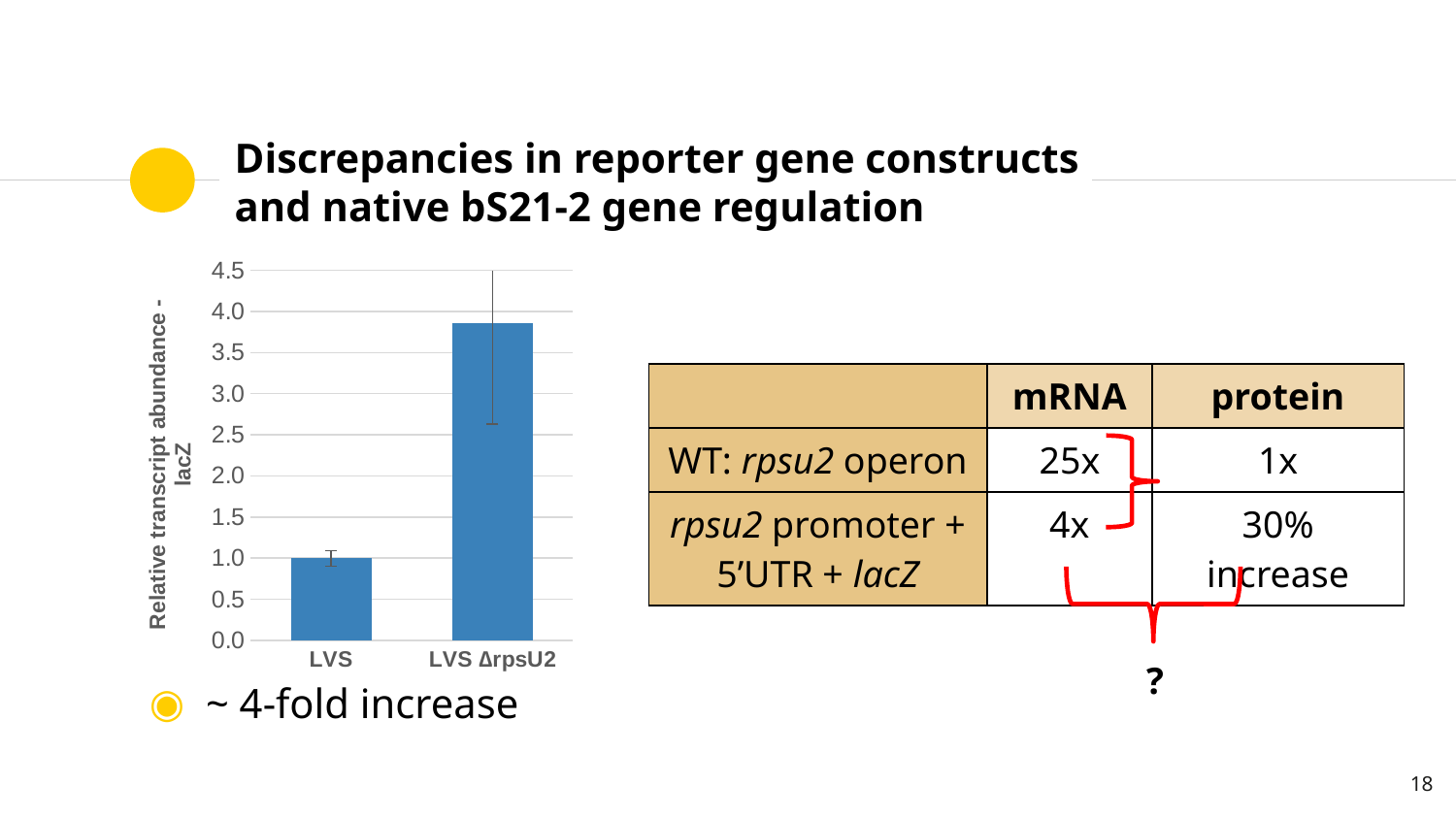
What is the y-axis title of the bar chart? Relative transcript abundance - lacZ Is the value for LVS ΔrpsU2 greater or less than 3.0? greater Which bar is taller, LVS or LVS ΔrpsU2? LVS ΔrpsU2 What is the highest tick value shown on the y axis of the bar chart? 4.5 Which category has the lowest relative transcript abundance in the bar chart? LVS What is the relative transcript abundance value for LVS in the bar chart? 1.0 Is the value for LVS greater or less than 1.5? less Is the value for LVS ΔrpsU2 greater or less than 4.5? less What kind of chart is shown on the slide? bar chart How many categories are plotted on the x axis of the bar chart? 2 Which category has the highest relative transcript abundance in the bar chart? LVS ΔrpsU2 Do the bar values rise or fall going from LVS to LVS ΔrpsU2? rise